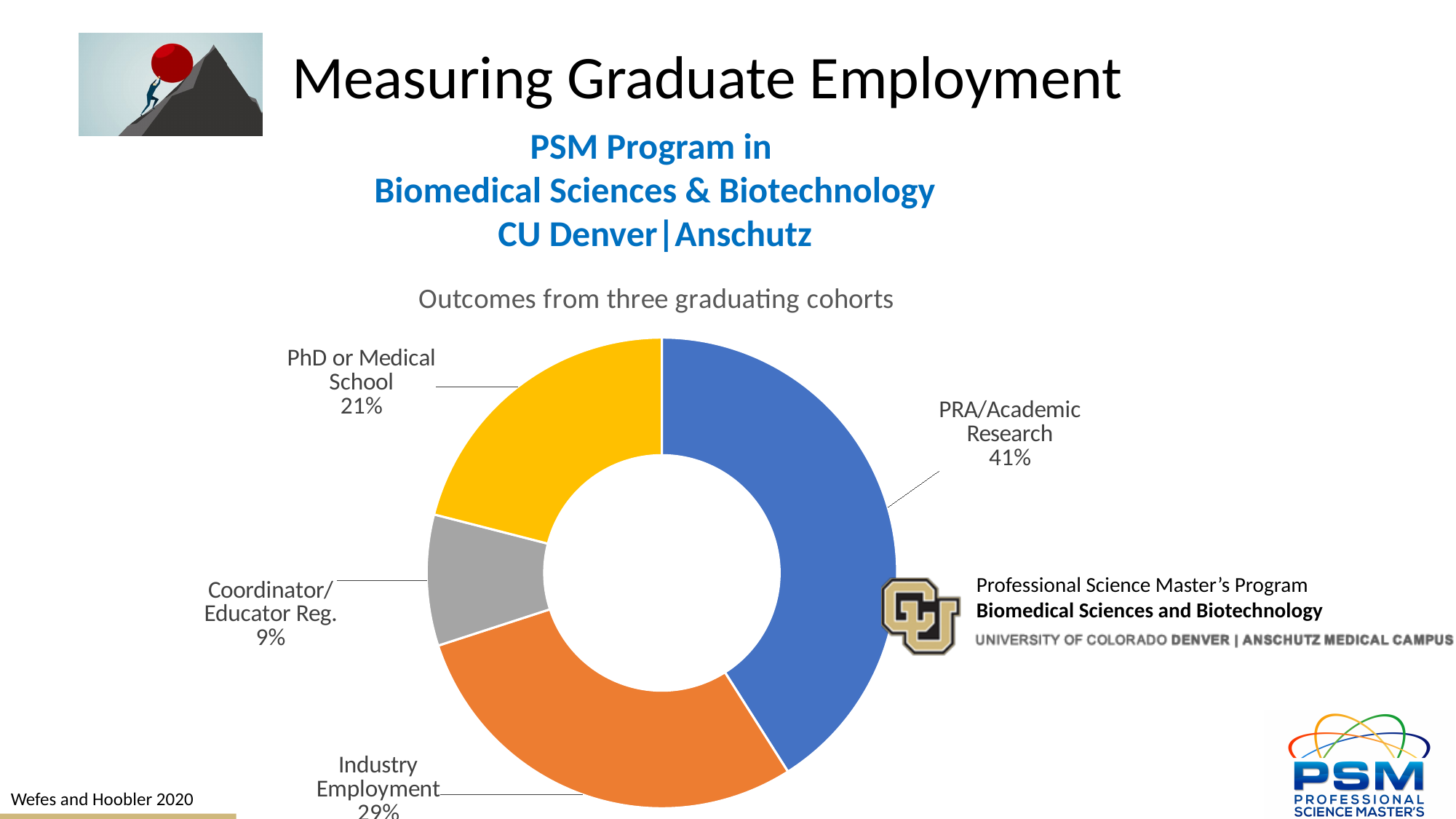
How many outcome categories are shown in the chart? 4 What is the difference in percentage points between PRA/Academic Research and Industry Employment? 12 What share of outcomes is PRA/Academic Research? 41% Which outcome category has the smallest share? Coordinator/Educator Reg. What is the title of the chart? Outcomes from three graduating cohorts What share of outcomes is Coordinator/Educator Reg.? 9% Which is larger, the share for Industry Employment or the share for PhD or Medical School? Industry Employment What kind of chart is shown on the slide? Doughnut (pie) chart What colour is the PRA/Academic Research slice? Blue What share of outcomes is Industry Employment? 29% Which outcome category has the largest share? PRA/Academic Research What share of outcomes is PhD or Medical School? 21%